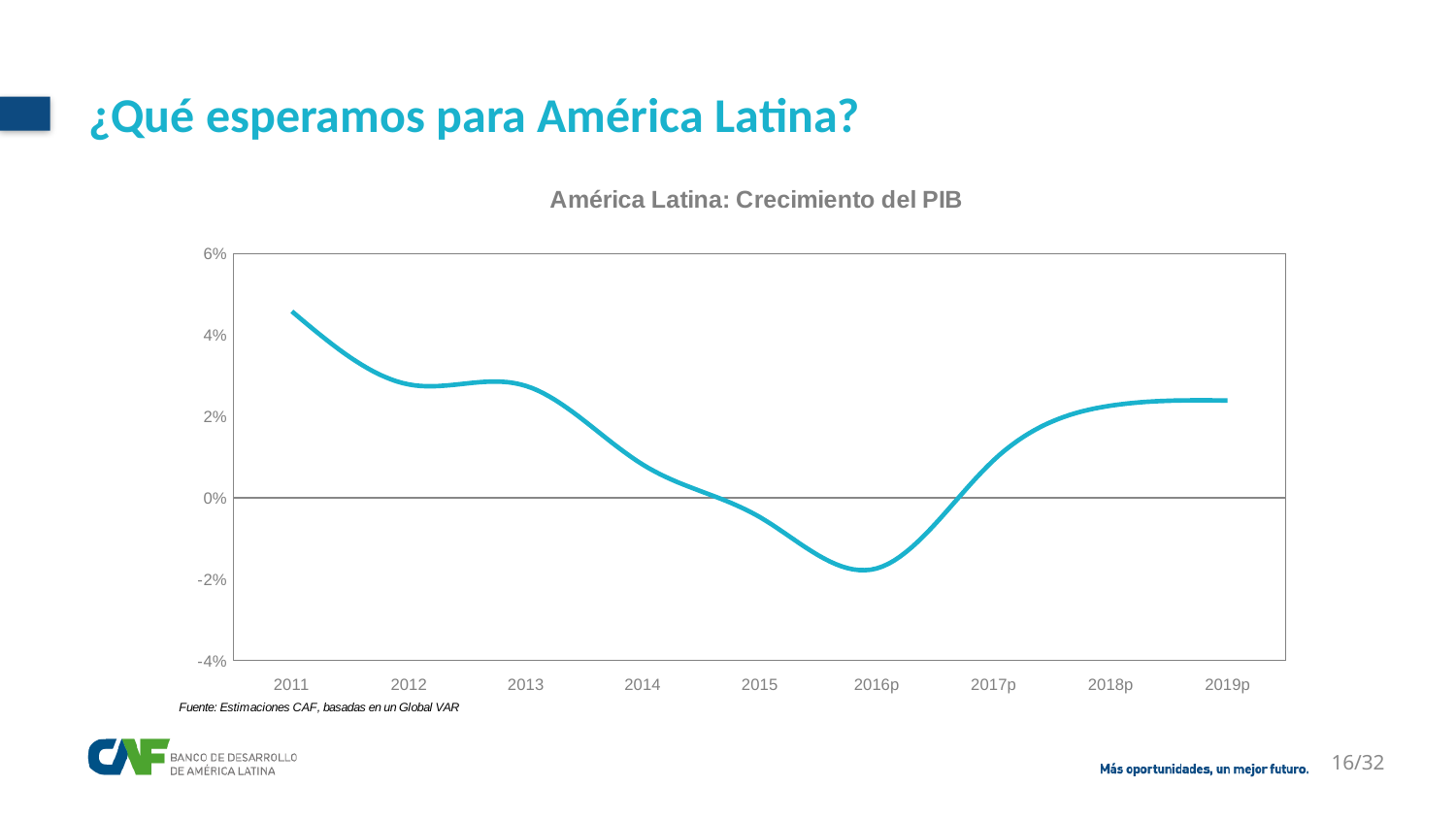
Is the value for 2014 greater or less than 2%? less Is the value for 2016p greater or less than 0%? less Is the value for 2011 greater or less than 4%? greater Which year has the lowest GDP growth value in the chart? 2016p Which year has the highest GDP growth value in the chart? 2011 What is the title of the chart? América Latina: Crecimiento del PIB Do the values rise or fall from 2016p to 2019p? rise What kind of chart is shown on the slide? line chart Do the values rise or fall from 2011 to 2016p? fall How many years are shown on the x axis of the chart? 9 Which is larger, the value for 2011 or the value for 2019p? 2011